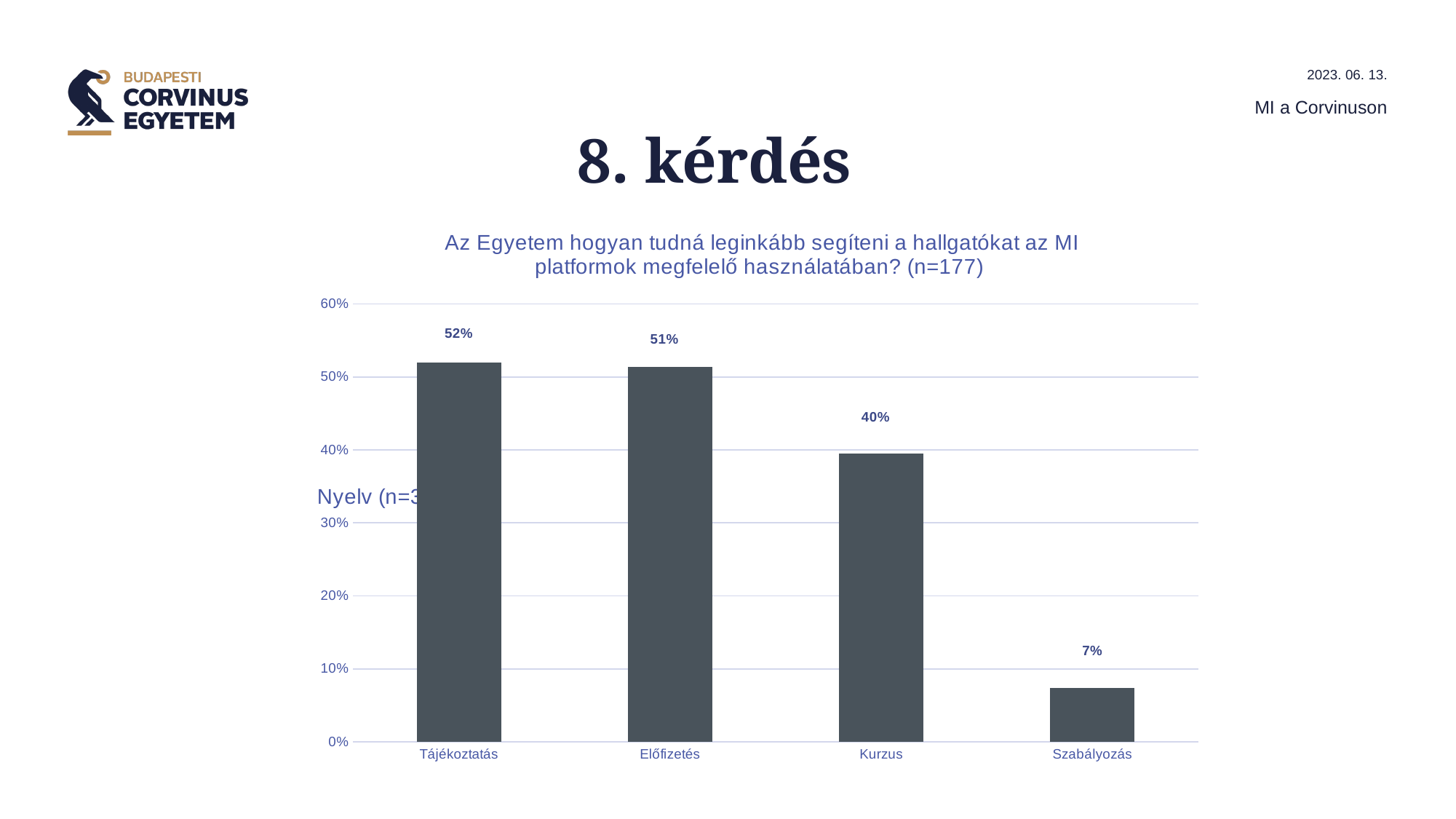
What is the value for Tájékoztatás? 52% What is the difference between the values for Tájékoztatás and Szabályozás? 45 percentage points What is the value for Kurzus? 40% Which category has the highest value? Tájékoztatás Is the value for Kurzus greater or less than 30%? greater What kind of chart is shown on the slide? bar chart Which category has the lowest value? Szabályozás What is the value for Szabályozás? 7% What is the value for Előfizetés? 51% How many categories are shown on the x axis? 4 Which is larger, the value for Kurzus or the value for Szabályozás? Kurzus What sample size (n) is given in the chart title? n=177